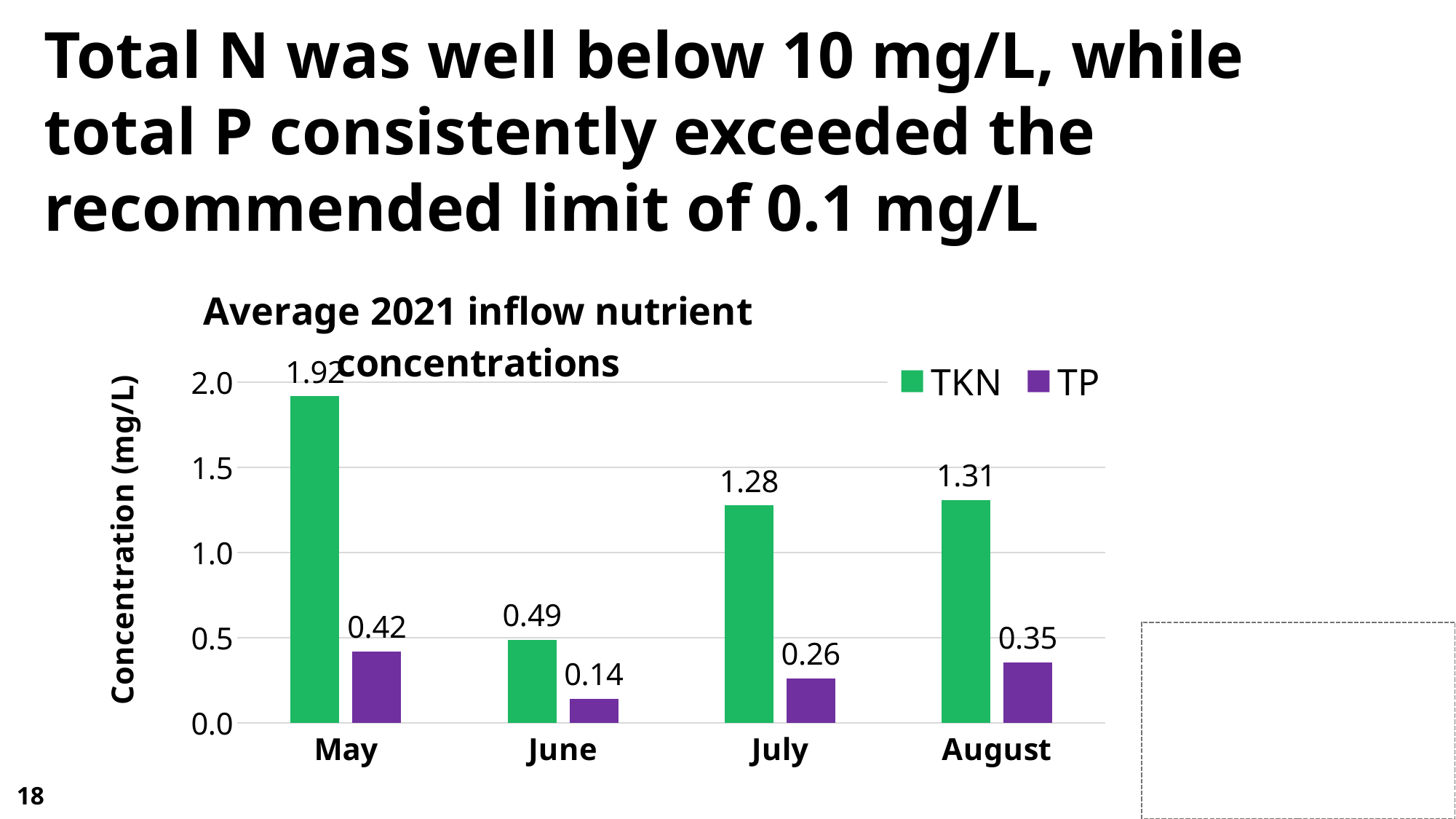
Is the TKN value for July greater or less than 1.0? greater What is the TKN value for May? 1.92 How many series does the legend list? 2 Which is larger, the TP value for May or the TP value for August? May How many months are shown on the x axis? 4 What is the difference between the TKN values for May and June? 1.43 What is the title of the chart? Average 2021 inflow nutrient concentrations Which month has the highest TKN value? May What kind of chart is shown? bar chart What is the TKN value for August? 1.31 Which month has the lowest TP value? June What is the TP value for June? 0.14